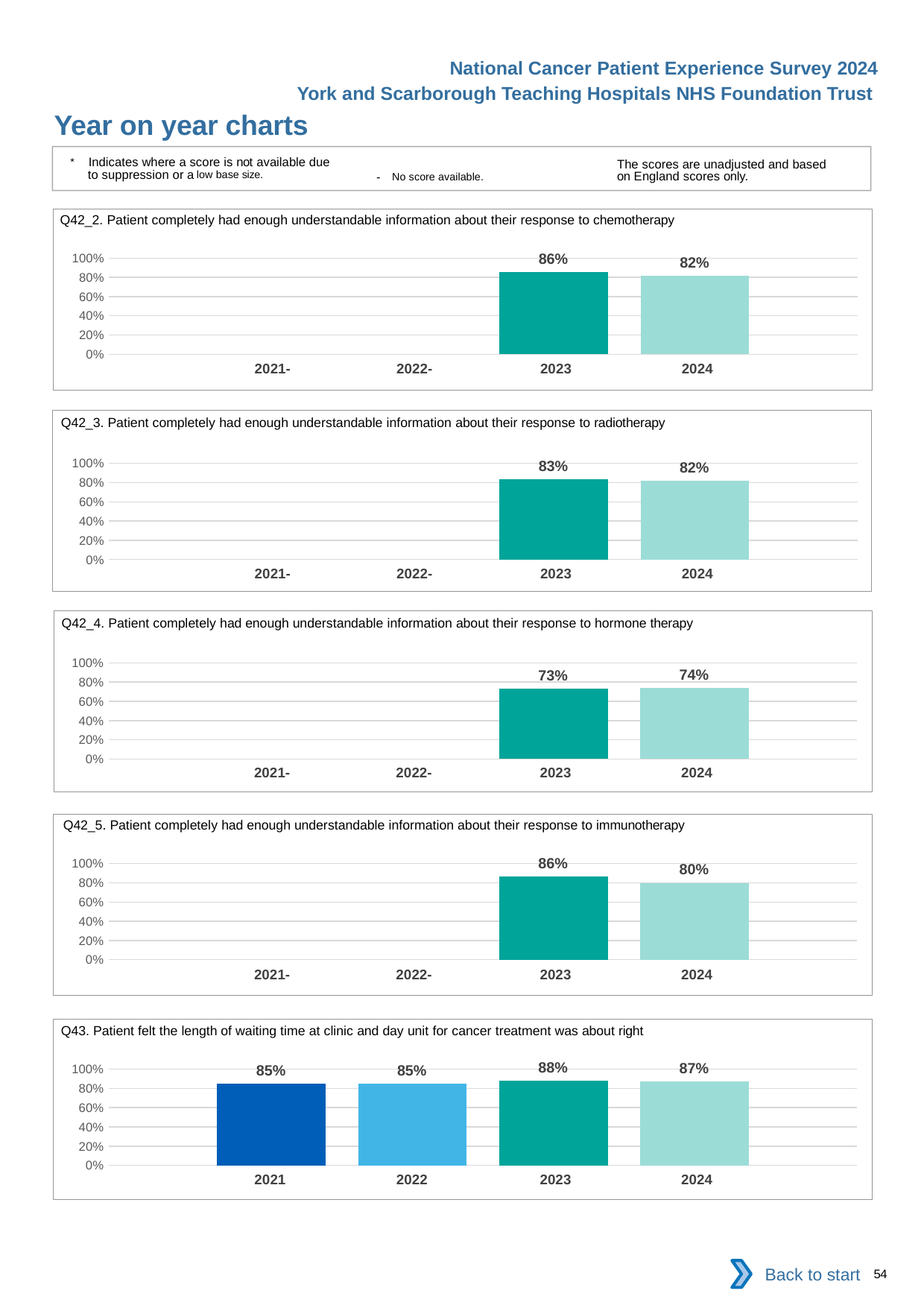
In the Q42_2 chart (chemotherapy), what is the difference between the 2023 and 2024 values? 4% In the Q42_4 chart (hormone therapy), what is the value for 2023? 73% In the Q43 chart (waiting time at clinic and day unit), how many bars are plotted? 4 In the Q42_3 chart (radiotherapy), which year has the higher value, 2023 or 2024? 2023 In the Q42_5 chart (immunotherapy), what is the value for 2024? 80% In the Q42_3 chart (radiotherapy), what is the value for 2024? 82% In the Q42_2 chart (chemotherapy), what is the value for 2023? 86% In the Q43 chart (waiting time at clinic and day unit), what is the value for 2021? 85% In the Q43 chart (waiting time at clinic and day unit), which year has the highest value? 2023 In the Q42_5 chart (immunotherapy), what is the difference between the 2023 and 2024 values? 6% What type of chart is the Q43 chart at the bottom of the slide? Bar chart In the Q42_4 chart (hormone therapy), is the value for 2024 greater or less than 80%? less